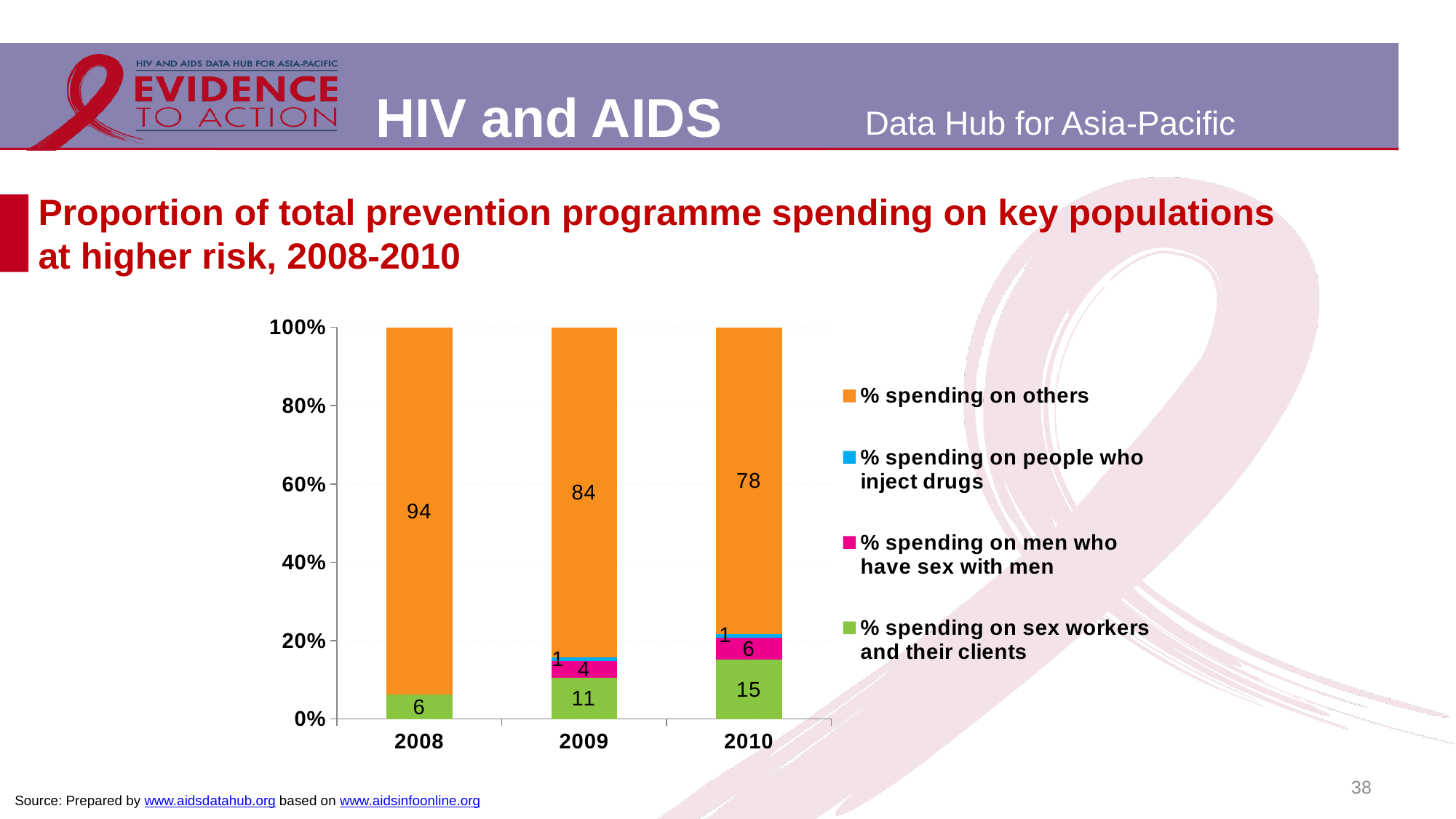
What is the value for % spending on men who have sex with men in 2009? 4 What is the value for % spending on sex workers and their clients in 2010? 15 In which year is % spending on others the lowest? 2010 How many years are shown on the x axis of the chart? 3 Does % spending on sex workers and their clients rise or fall from 2008 to 2010? Rise In which year is % spending on sex workers and their clients the highest? 2010 What is the difference between % spending on others in 2008 and in 2010? 16 Which is larger: % spending on men who have sex with men in 2009 or in 2010? 2010 What kind of chart is shown on the slide? Stacked bar chart What is the value for % spending on others in 2008? 94 What is the value for % spending on people who inject drugs in 2010? 1 How many series does the chart legend list? 4